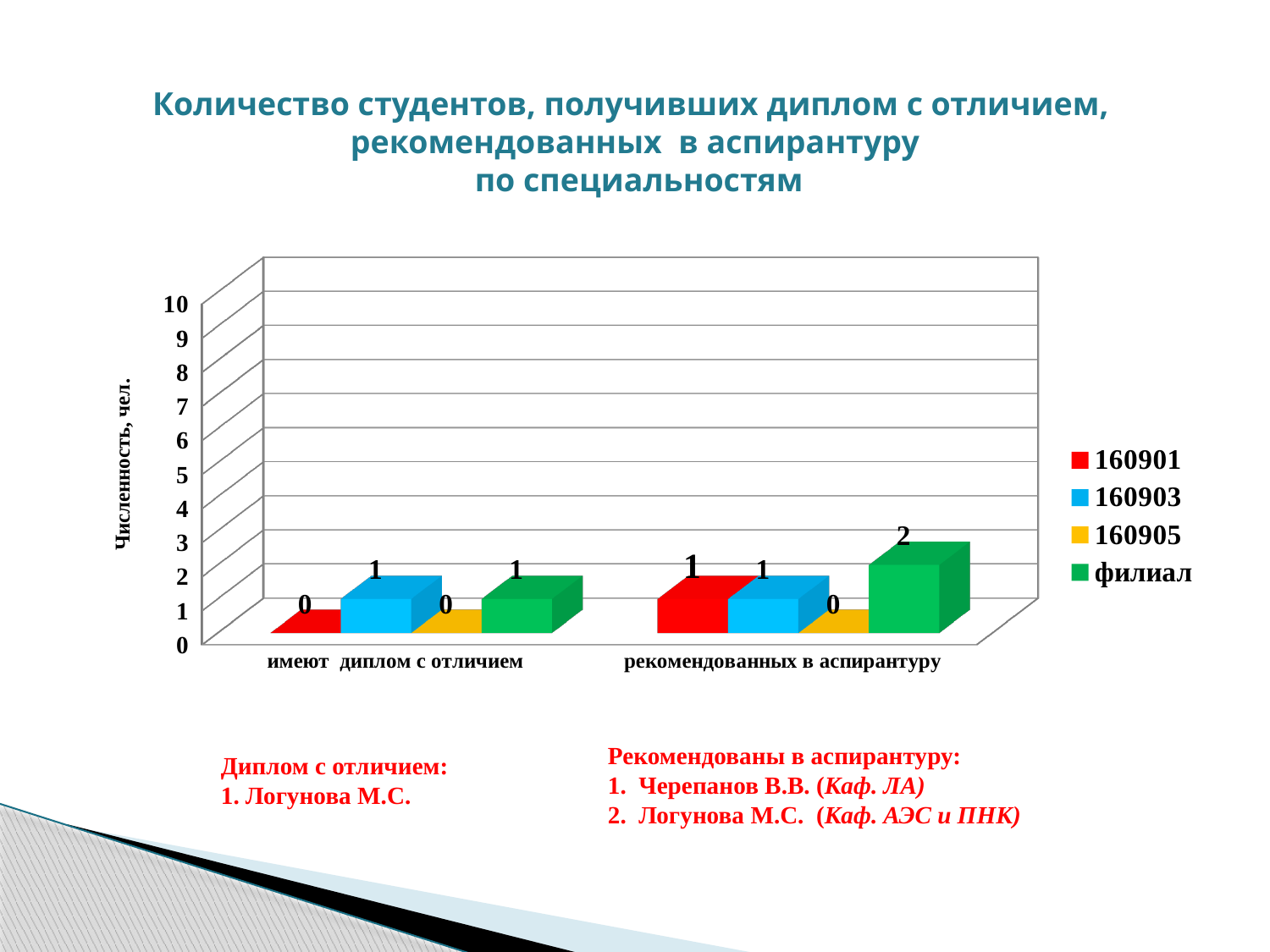
How many series does the legend list? 4 Which is larger: the 160901 value for "имеют диплом с отличием" or the 160901 value for "рекомендованных в аспирантуру"? рекомендованных в аспирантуру How many categories are shown on the x axis? 2 What is the difference between the филиал value and the 160901 value in the category "рекомендованных в аспирантуру"? 1 What is the value for 160903 in the category "имеют диплом с отличием"? 1 What is the value for 160901 in the category "имеют диплом с отличием"? 0 What is the value for 160905 in the category "рекомендованных в аспирантуру"? 0 What is the value for филиал in the category "рекомендованных в аспирантуру"? 2 What type of chart is shown on the slide? bar chart What is the label of the vertical axis? Численность, чел. Which series has the highest value in the category "рекомендованных в аспирантуру"? филиал Is the value for филиал in "рекомендованных в аспирантуру" greater or less than 5? less